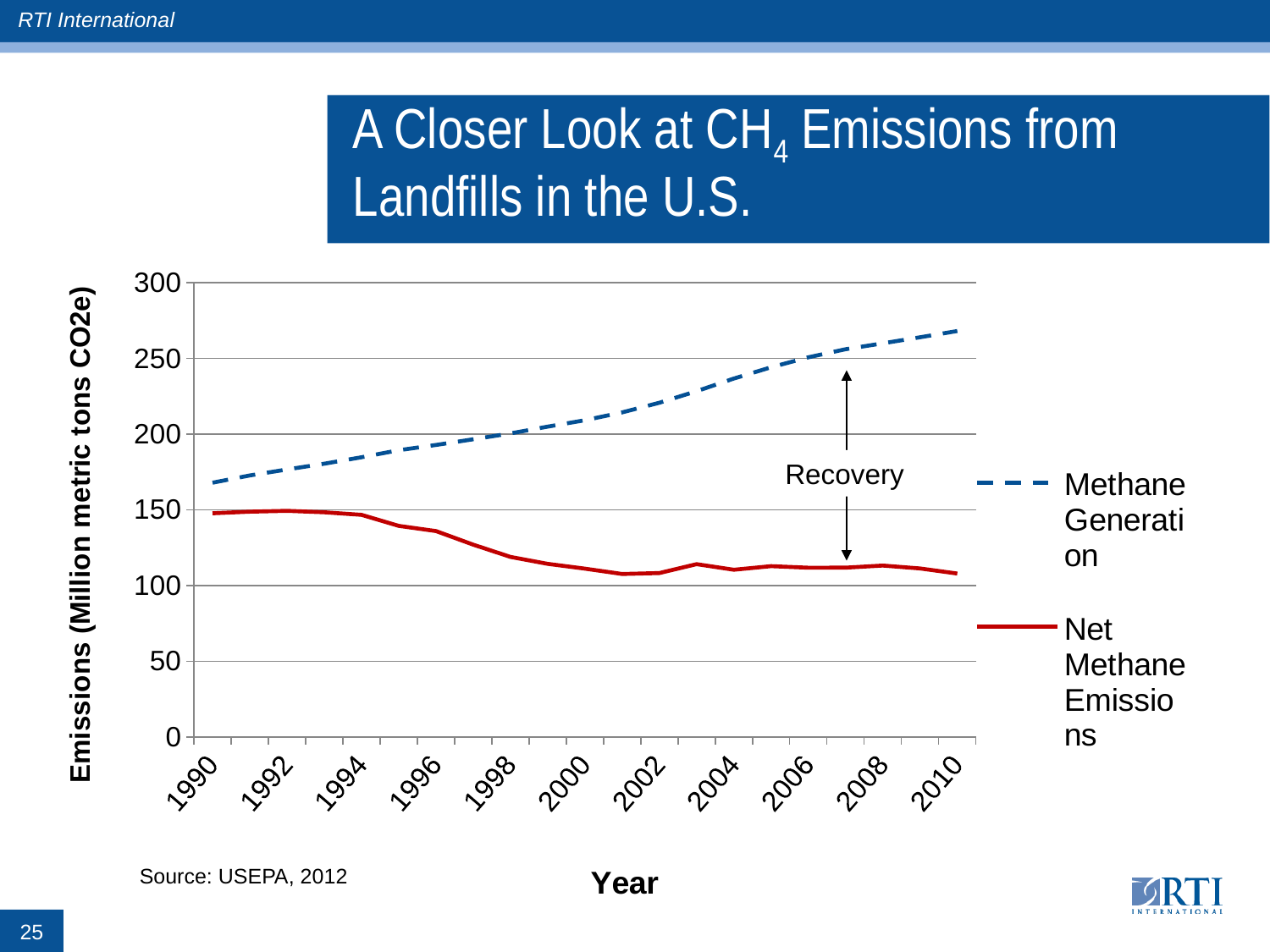
Is the Net Methane Emissions value in 2010 greater or less than 150? less Does the Methane Generation series rise or fall from 1990 to 2010? rise How many year labels are shown on the x axis? 11 Is the Methane Generation value in 2006 greater or less than 200? greater What is the label of the y axis? Emissions (Million metric tons CO2e) What kind of chart is shown on the slide? line chart What word labels the gap between the two lines on the chart? Recovery In 2010, which series has the higher value, Methane Generation or Net Methane Emissions? Methane Generation How many series does the chart's legend list? 2 Is the Methane Generation value in 1990 greater or less than 150? greater Does the Net Methane Emissions series rise or fall overall from 1990 to 2010? fall